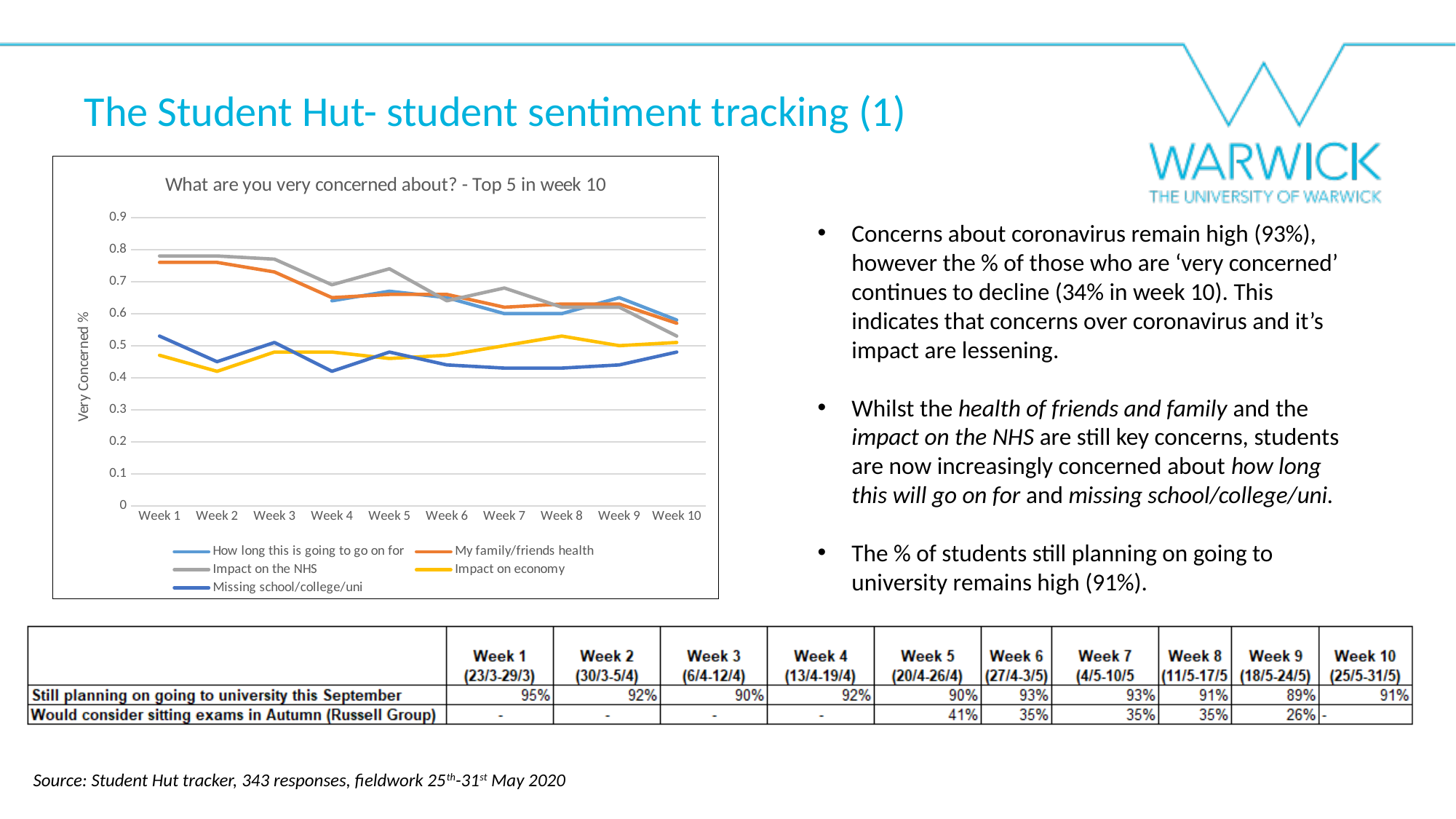
Is the value for Impact on the NHS in Week 1 greater or less than 0.7? greater Does the Impact on the NHS line rise or fall from Week 1 to Week 10? Fall What kind of chart is shown on the slide? Line chart How many series does the legend of the chart list? 5 Is the value for My family/friends health in Week 10 greater or less than 0.6? less How many weeks are shown along the x axis of the chart? 10 What is the title of the chart? What are you very concerned about? - Top 5 in week 10 What is the label on the vertical axis of the chart? Very Concerned % Which series has the highest value in Week 7? Impact on the NHS Is the value for Missing school/college/uni in Week 4 greater or less than 0.5? less Which series has the lowest value in Week 4? Missing school/college/uni